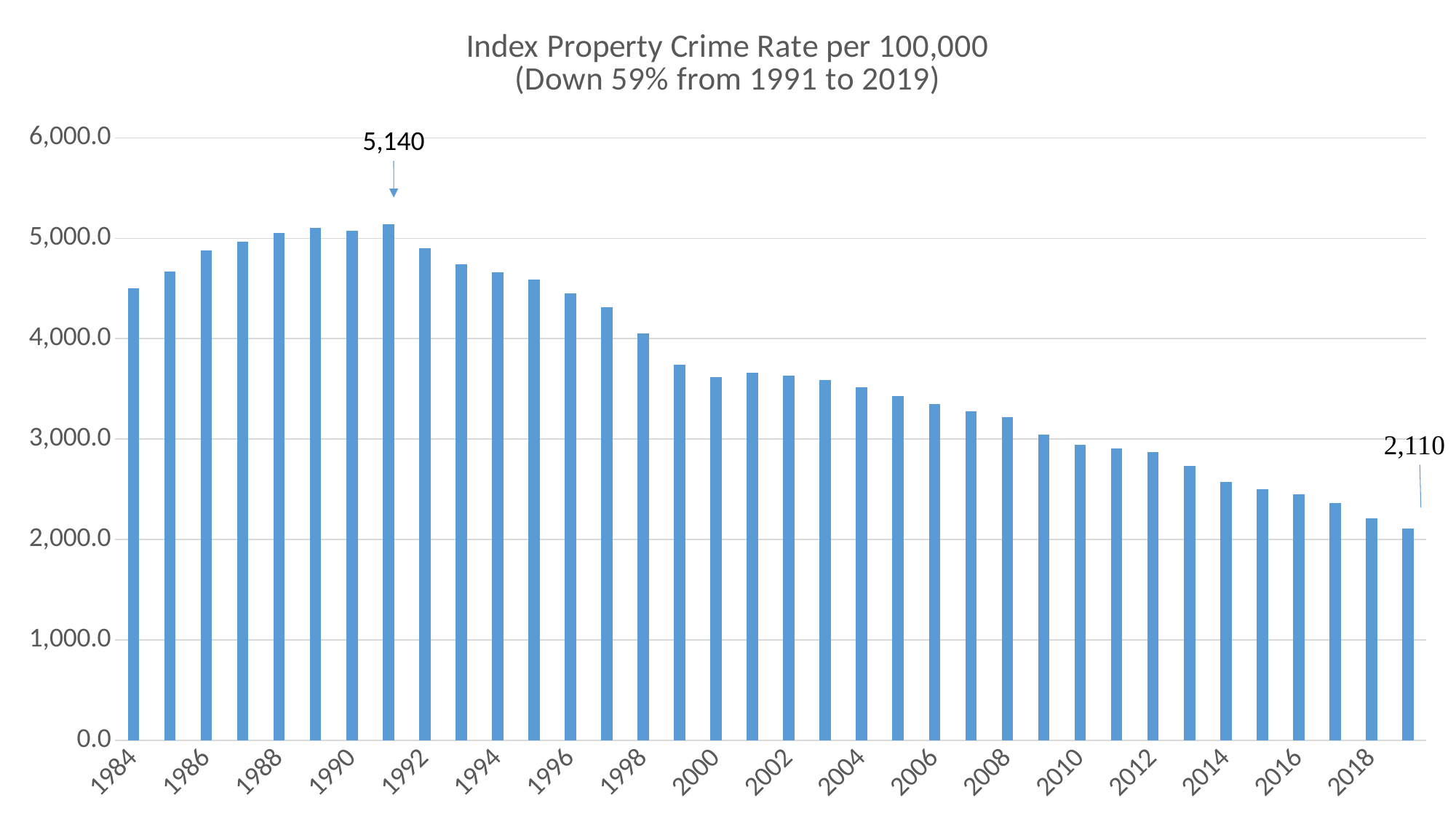
According to the chart title, by what percentage did the rate fall from 1991 to 2019? 59% What kind of chart is shown on the slide? bar chart Which year has the highest index property crime rate? 1991 How many years (bars) are plotted in the chart? 36 Is the value for 2014 greater or less than 3,000? less What is the index property crime rate per 100,000 for 1991? 5,140 From 1991 to 2019, do the values rise or fall along the x axis? fall Is the value for 1984 greater or less than 4,000? greater What is the index property crime rate per 100,000 for 2019? 2,110 Which year has the larger index property crime rate, 1991 or 2019? 1991 What is the difference between the 1991 rate and the 2019 rate? 3,030 Which year has the lowest index property crime rate? 2019